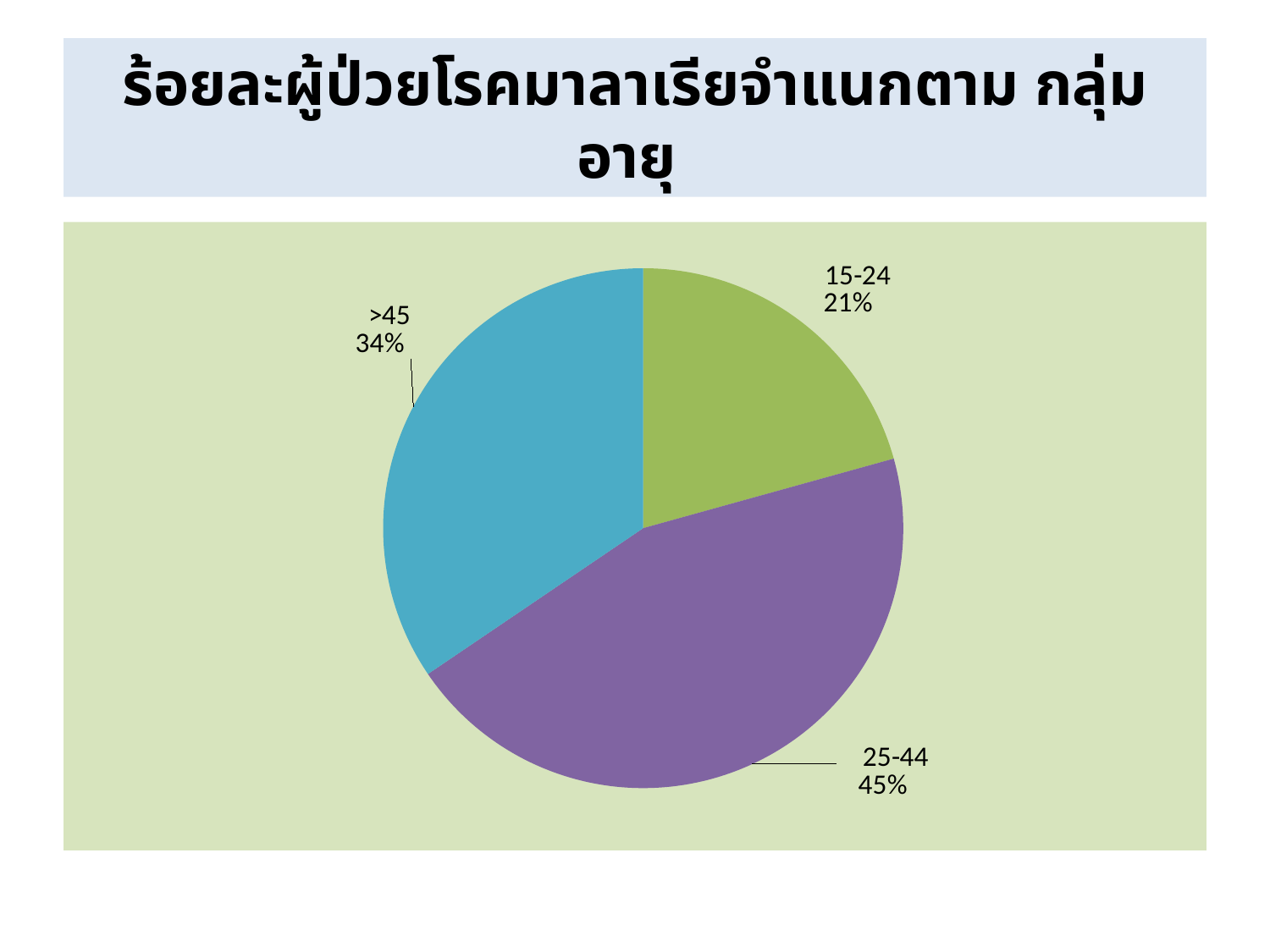
What kind of chart is shown on the slide? pie chart What is the difference in percentage points between the 25-44 and >45 age groups? 11 What share of the pie does the >45 age group have? 34% Which age group has the largest share of the pie? 25-44 Which age group has the smallest share of the pie? 15-24 What colour is the slice for the >45 age group? blue How many age groups are shown in the pie chart? 3 What colour is the slice for the 25-44 age group? purple What share of the pie does the 25-44 age group have? 45% Which has a larger share, the >45 group or the 15-24 group? >45 What is the difference in percentage points between the >45 and 15-24 age groups? 13 What share of the pie does the 15-24 age group have? 21%